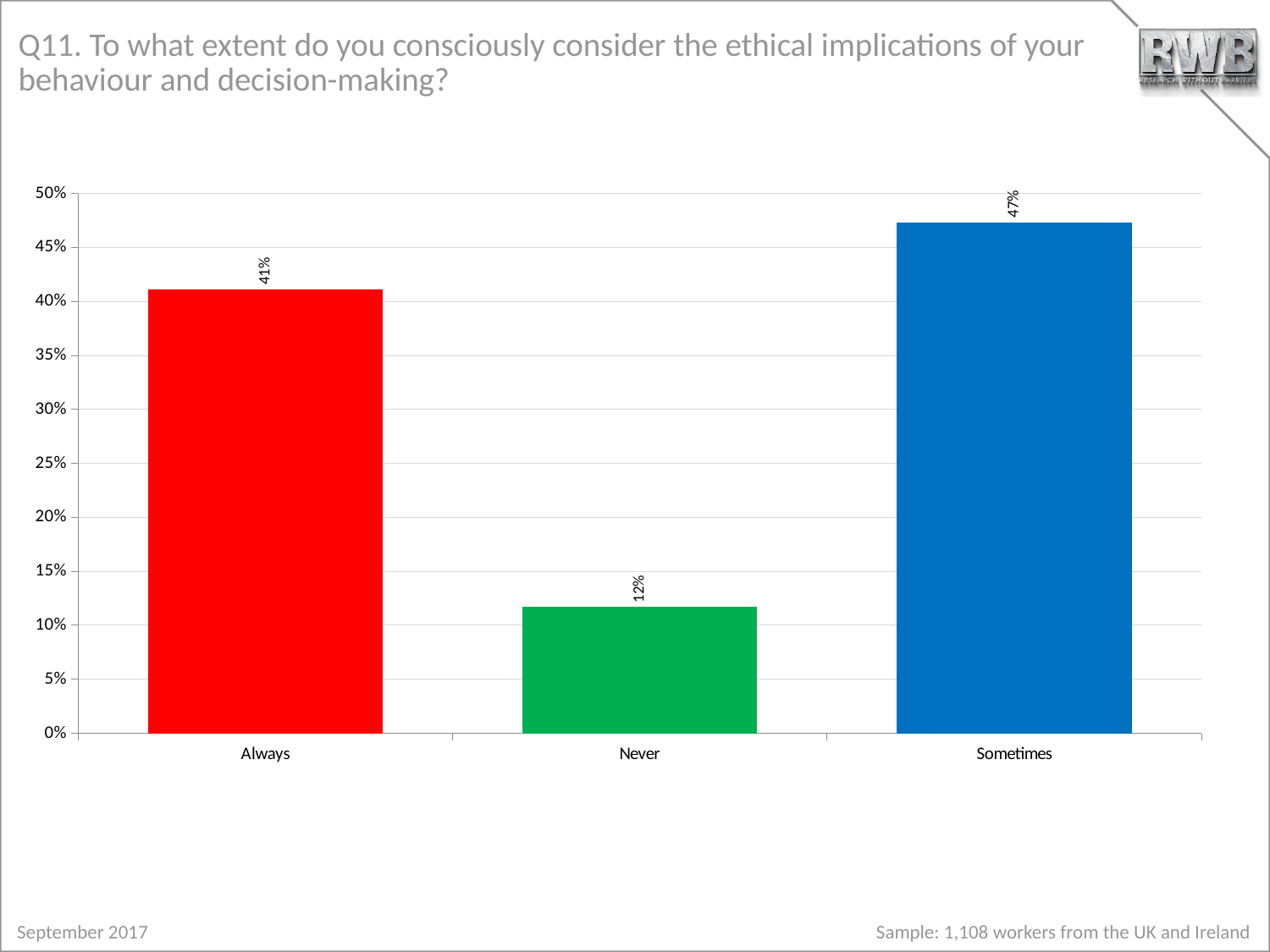
Which category has the lowest value? Never What kind of chart is shown on the slide? bar chart How many categories are shown on the x axis? 3 What is the value for Sometimes? 47% What is the value for Always? 41% Which is larger, the value for Always or the value for Never? Always What is the difference between the values for Always and Never? 29% What is the value for Never? 12% Which category has the highest value? Sometimes Is the value for Sometimes greater or less than 45%? greater What is the difference between the values for Sometimes and Always? 6% What colour is the bar for Never? green